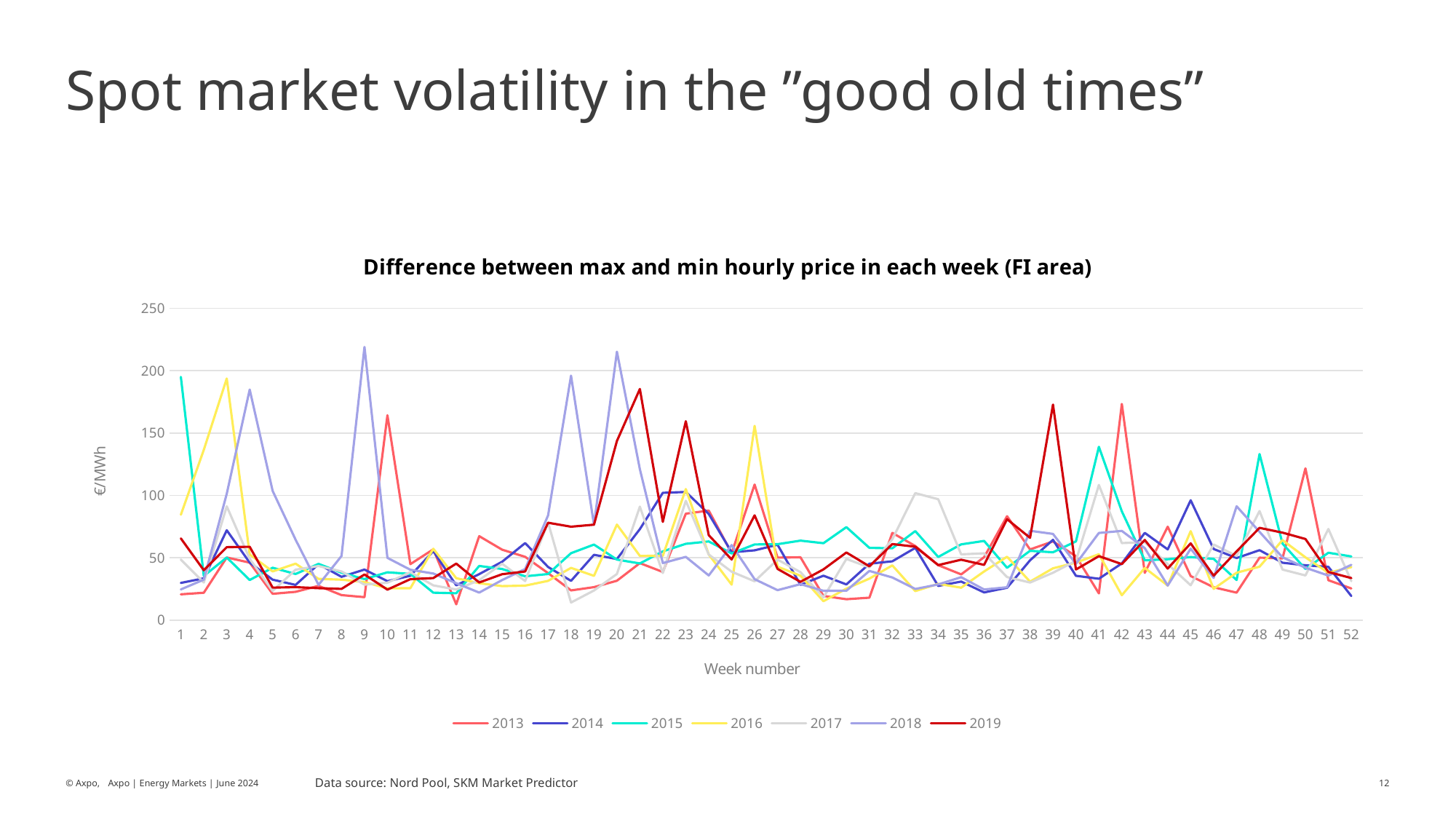
How many series does the legend list? 7 In which week does the 2016 series reach its highest value? Week 3 What kind of chart is shown on the slide? Line chart Which is larger: the value for 2018 in week 9 or the value for 2013 in week 10? 2018 in week 9 Is the value for 2013 in week 13 greater or less than 50? less Is the value for 2018 in week 9 greater or less than 200? greater Which series reaches the highest value anywhere on the chart? 2018 Is the value for 2016 in week 3 greater or less than 150? greater What is the title of the chart? Difference between max and min hourly price in each week (FI area) How many week numbers are shown along the x axis? 52 What unit is shown on the y axis? €/MWh